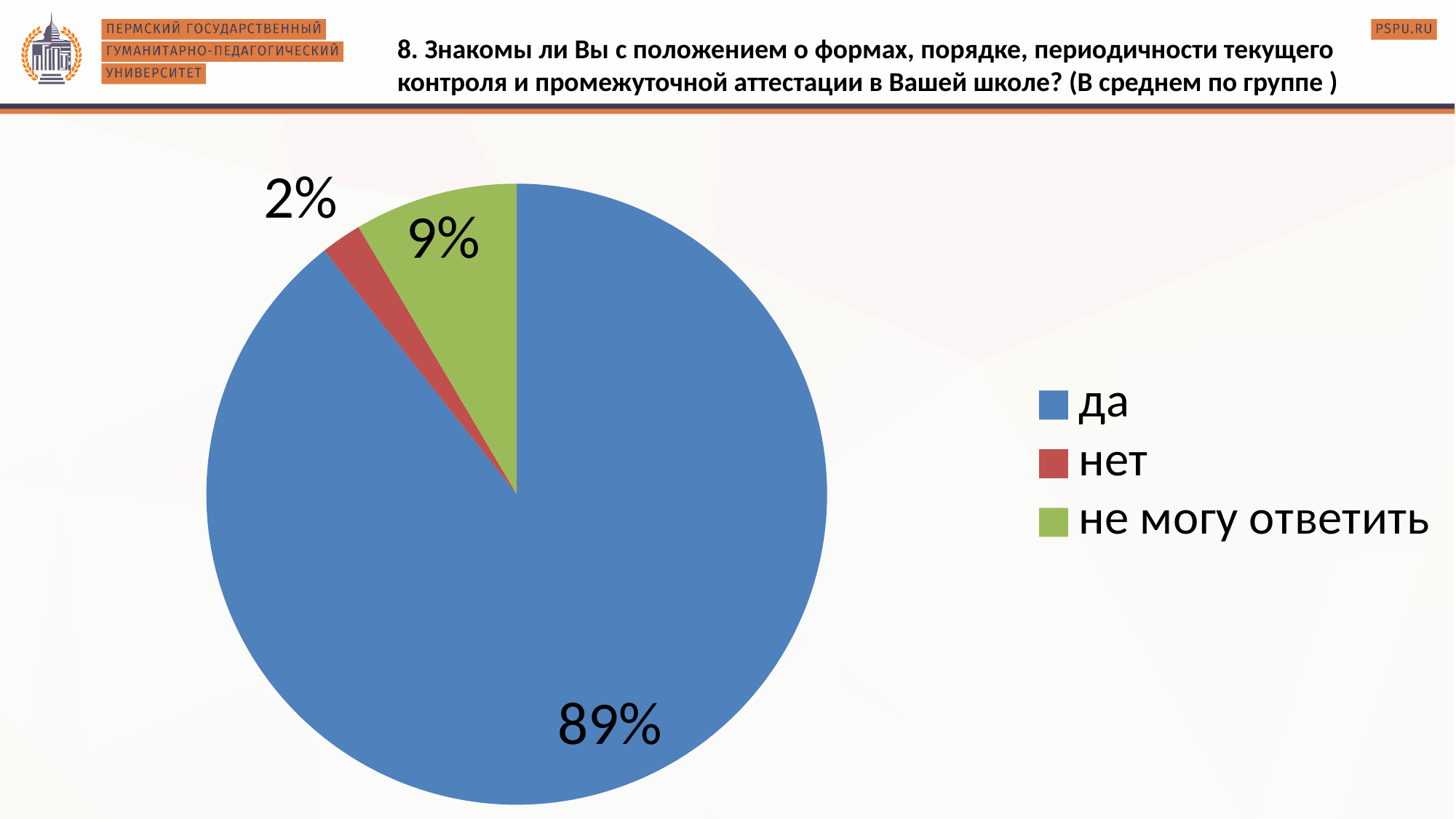
What share of the pie does "да" have? 89% Which category has the largest slice of the pie? да Which category has the smallest slice of the pie? нет Which is larger, the share for "нет" or the share for "не могу ответить"? не могу ответить How many categories does the pie chart show? 3 What share of the pie does "не могу ответить" have? 9% What kind of chart is shown on the slide? pie chart What share of the pie does "нет" have? 2% What is the difference in percentage points between "не могу ответить" and "нет"? 7 How many entries does the legend list? 3 What is the difference in percentage points between "да" and "не могу ответить"? 80 What colour is the slice for "не могу ответить"? green